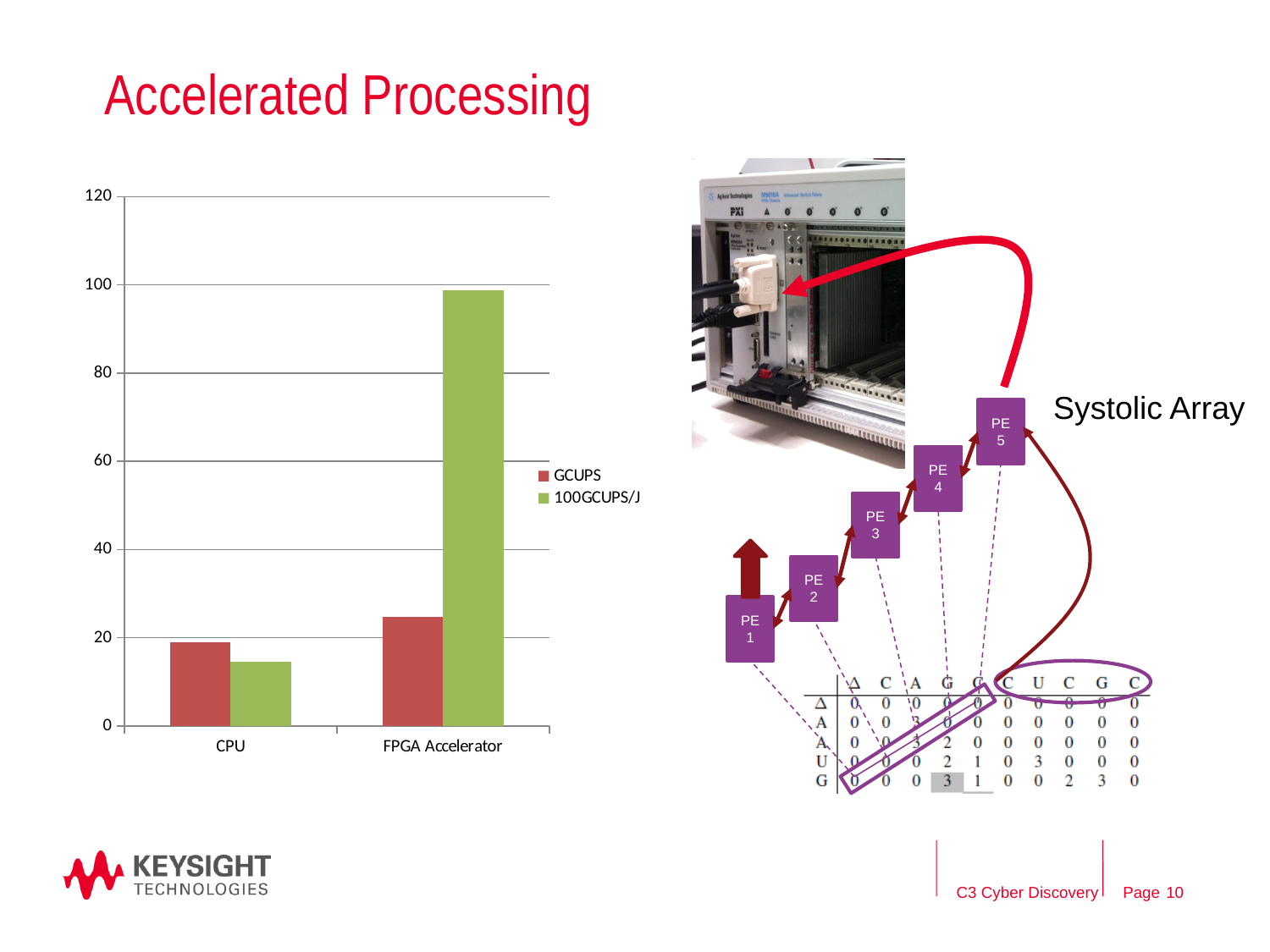
How many categories are shown on the x axis of the bar chart? 2 Which category has the higher 100GCUPS/J value, CPU or FPGA Accelerator? FPGA Accelerator Is the GCUPS value for FPGA Accelerator greater or less than 40? less Which category has the lowest 100GCUPS/J value? CPU How many series does the legend of the bar chart list? 2 What are the two series named in the legend of the bar chart? GCUPS and 100GCUPS/J Which category has the highest GCUPS value? FPGA Accelerator For CPU, which series has the larger value, GCUPS or 100GCUPS/J? GCUPS What kind of chart is shown on the left of the slide? bar chart Is the 100GCUPS/J value for FPGA Accelerator greater or less than 80? greater What colour are the GCUPS bars in the chart? red Is the GCUPS value for CPU greater or less than 40? less